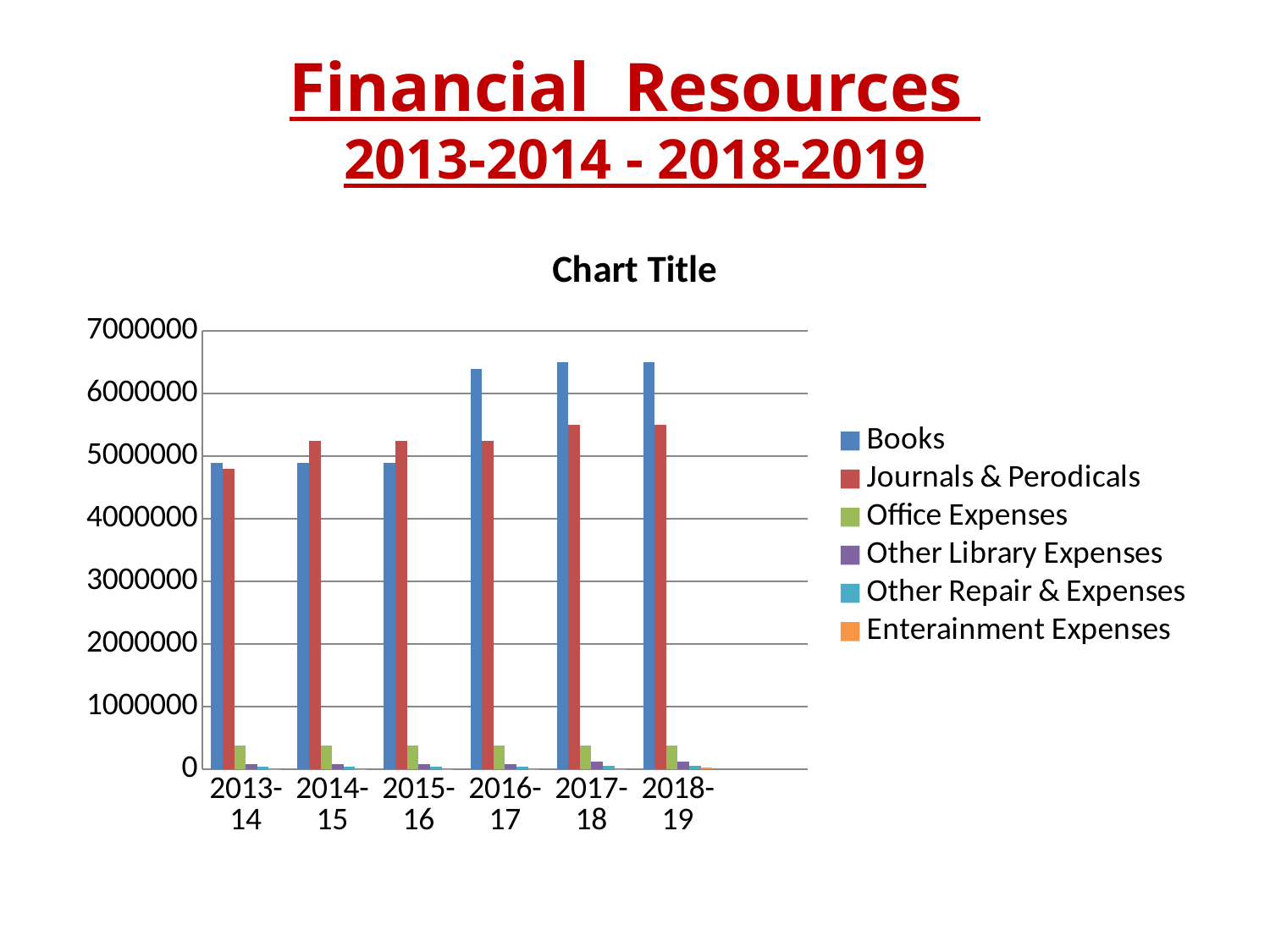
Is the value for Office Expenses in 2013-14 greater or less than 1000000? less Is the value for Journals & Perodicals in 2017-18 greater or less than 5000000? greater In 2016-17, which is larger: Books or Journals & Perodicals? Books Do the values for Books rise or fall from 2013-14 to 2018-19? rise In which year is the value for Journals & Perodicals lowest? 2013-14 Is the value for Books in 2013-14 greater or less than 5000000? less What kind of chart is shown on the slide? bar chart How many year categories are shown on the x axis? 6 How many series does the legend list? 6 What is the title shown above the chart? Chart Title In 2014-15, which is larger: Books or Journals & Perodicals? Journals & Perodicals